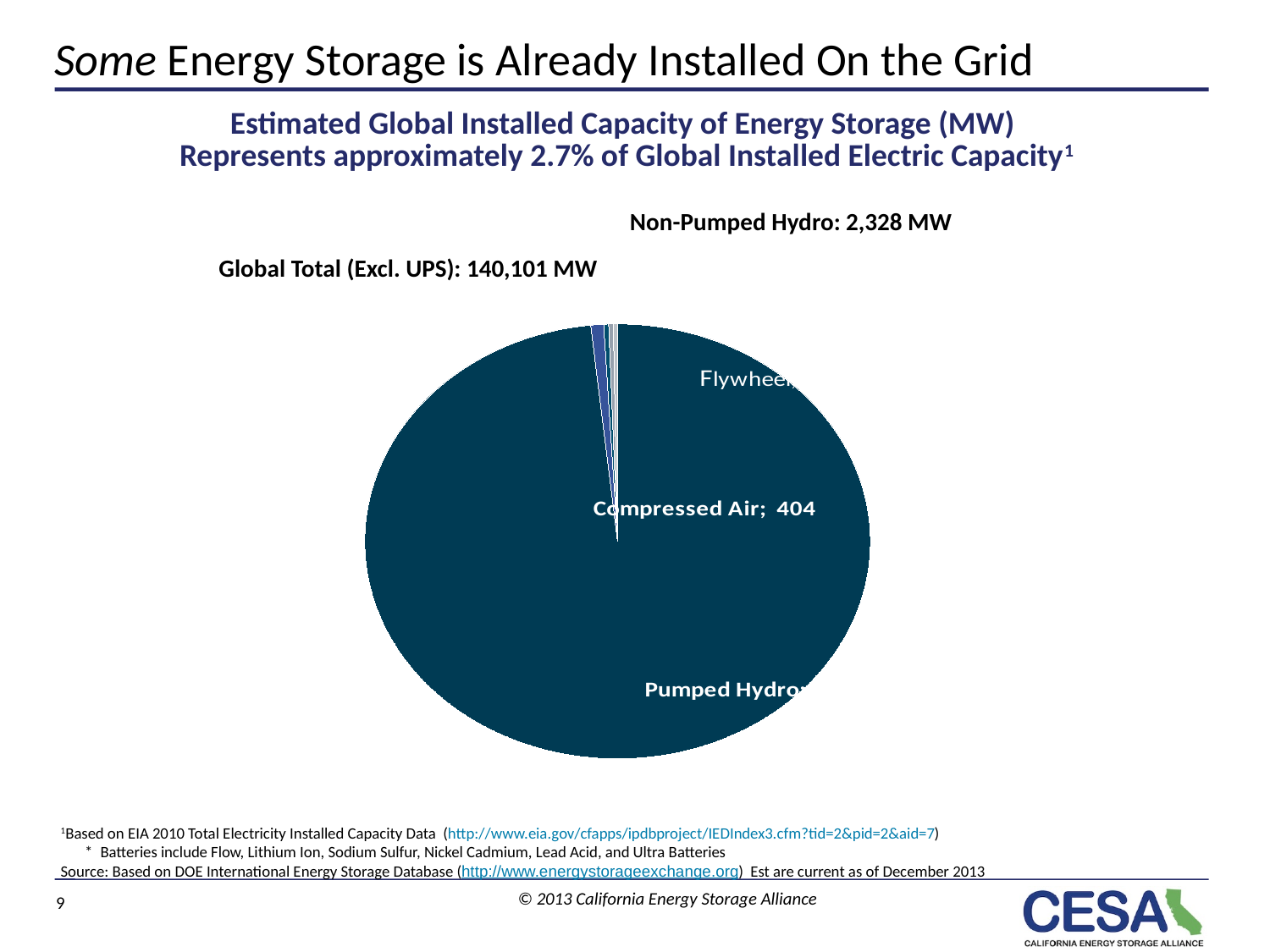
What is the Non-Pumped Hydro capacity stated on the slide? 2,328 MW What is the Global Total (Excl. UPS) capacity stated on the slide? 140,101 MW What kind of chart is shown on the slide? pie chart What value is shown for Compressed Air in the pie chart? 404 What is the first line of the chart's title? Estimated Global Installed Capacity of Energy Storage (MW) Which is larger in the pie chart, Pumped Hydro or Compressed Air? Pumped Hydro Which category has the largest slice of the pie chart? Pumped Hydro According to the chart title, what approximate share of global installed electric capacity does energy storage represent? 2.7%